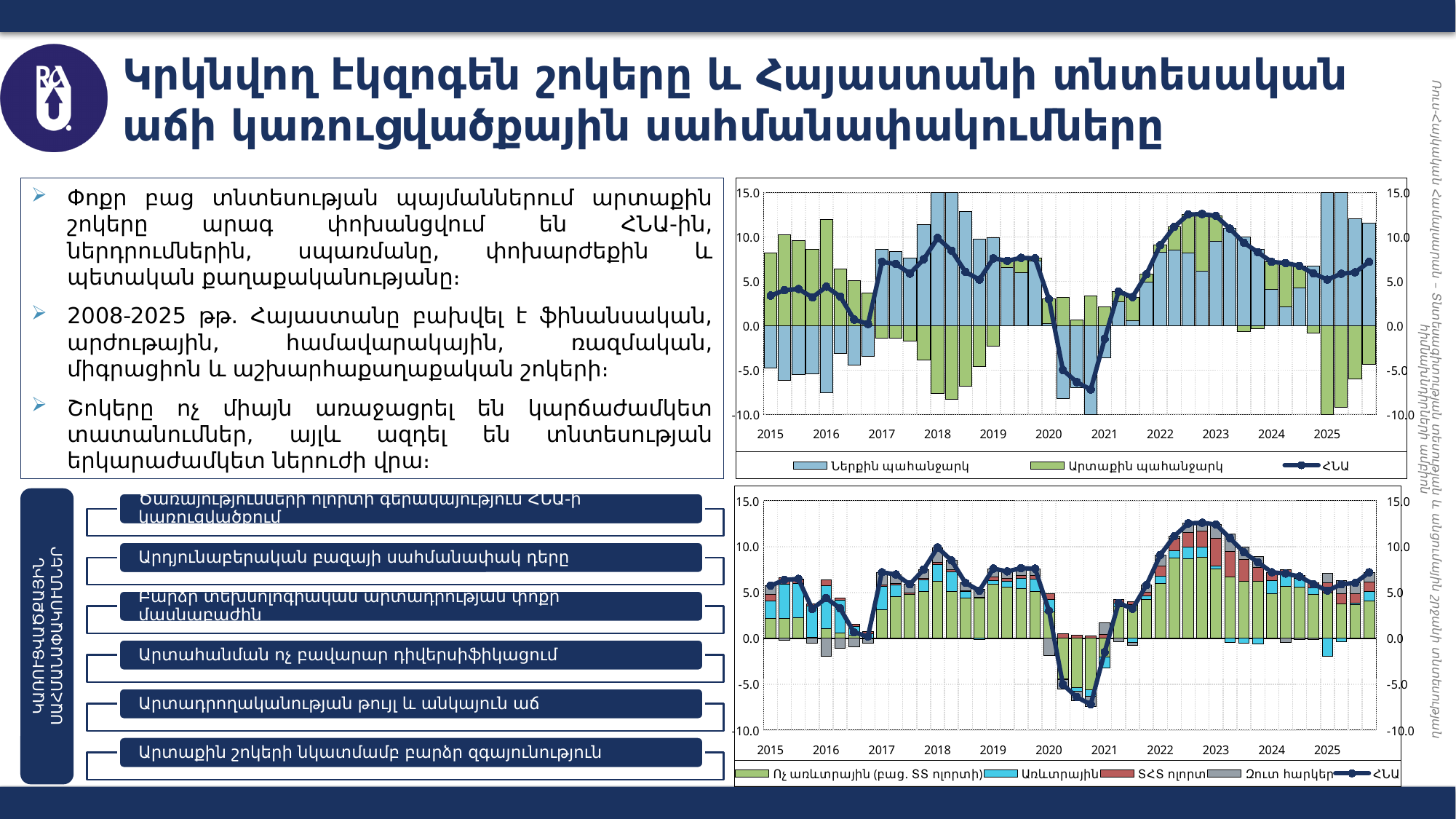
How many series does the legend of the top chart list? 3 In the top chart, is the peak value of the ՀՆԱ line in 2023 greater or less than 10.0? greater How many years are labelled on the x axis of the top chart? 11 How many series does the legend of the bottom chart list? 5 What is the first year labelled on the x axis of the bottom chart? 2015 In the top chart, is the lowest value of the ՀՆԱ line around 2020 greater or less than 0.0? less What is the last year labelled on the x axis of the top chart? 2025 In the bottom chart, is the peak value of the ՀՆԱ line in 2023 greater or less than 10.0? greater What is the maximum value shown on the y axis of the top chart? 15.0 What kind of chart is the top chart on the right side of the slide? bar chart with a line In the top chart, does the ՀՆԱ line rise or fall between 2023 and 2024? fall